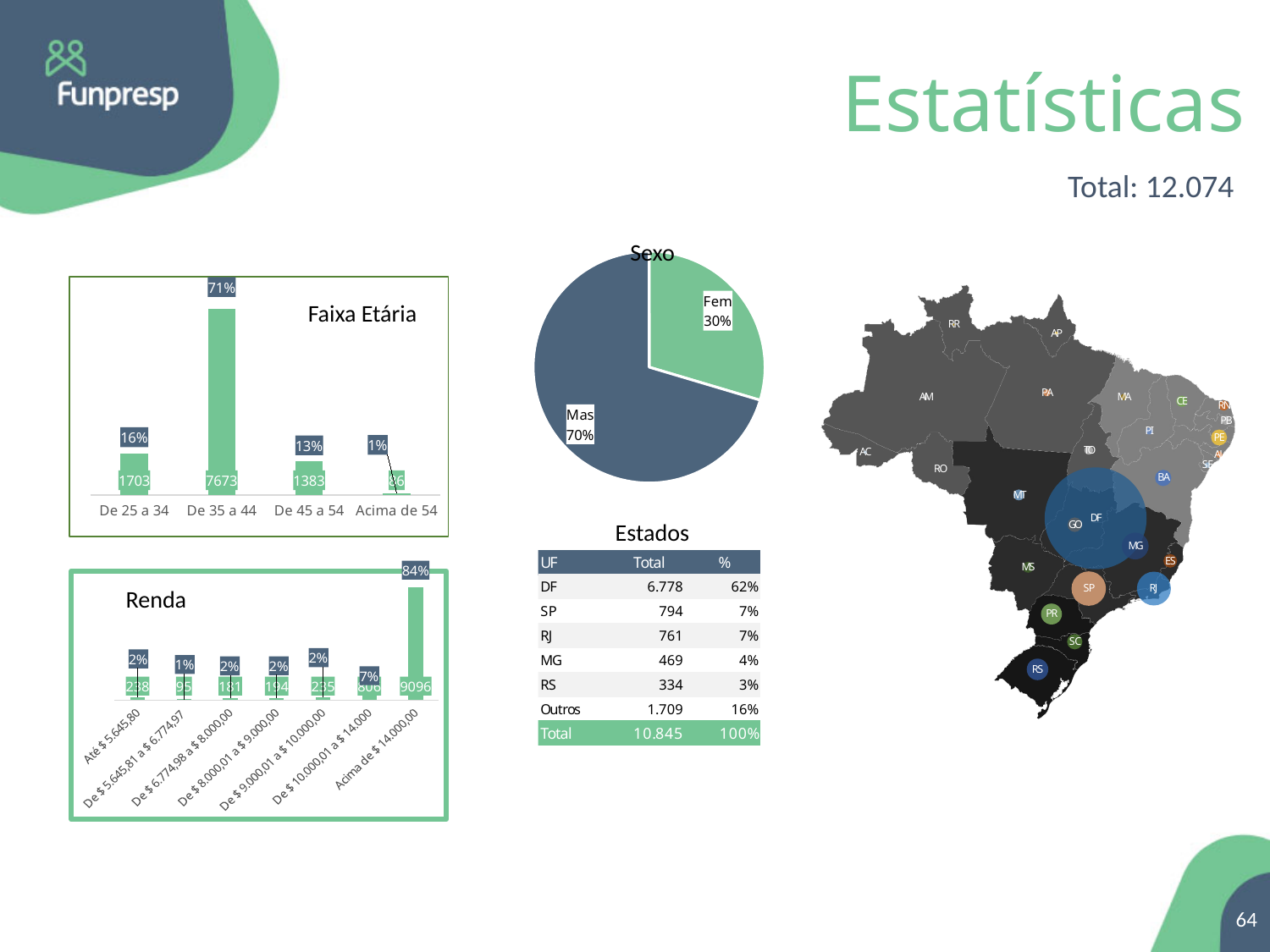
What kind of chart is the Faixa Etária chart? Bar chart In the Faixa Etária chart, what is the value for De 35 a 44? 7673 In the Sexo pie chart, which slice is larger, Mas or Fem? Mas In the Faixa Etária chart, which is larger: the value for De 25 a 34 or De 45 a 54? De 25 a 34 In the Faixa Etária chart, which age group has the lowest value? Acima de 54 How many age groups are shown in the Faixa Etária chart? 4 In the Faixa Etária chart, what is the difference between the values for De 35 a 44 and De 25 a 34? 5970 In the Renda chart, which income range has the highest value? Acima de $ 14.000,00 In the Renda chart, what percentage is shown for Acima de $ 14.000,00? 84% In the Faixa Etária chart, which age group has the highest value? De 35 a 44 In the Sexo pie chart, what share is Fem? 30% In the Faixa Etária chart, what percentage is shown for De 25 a 34? 16%